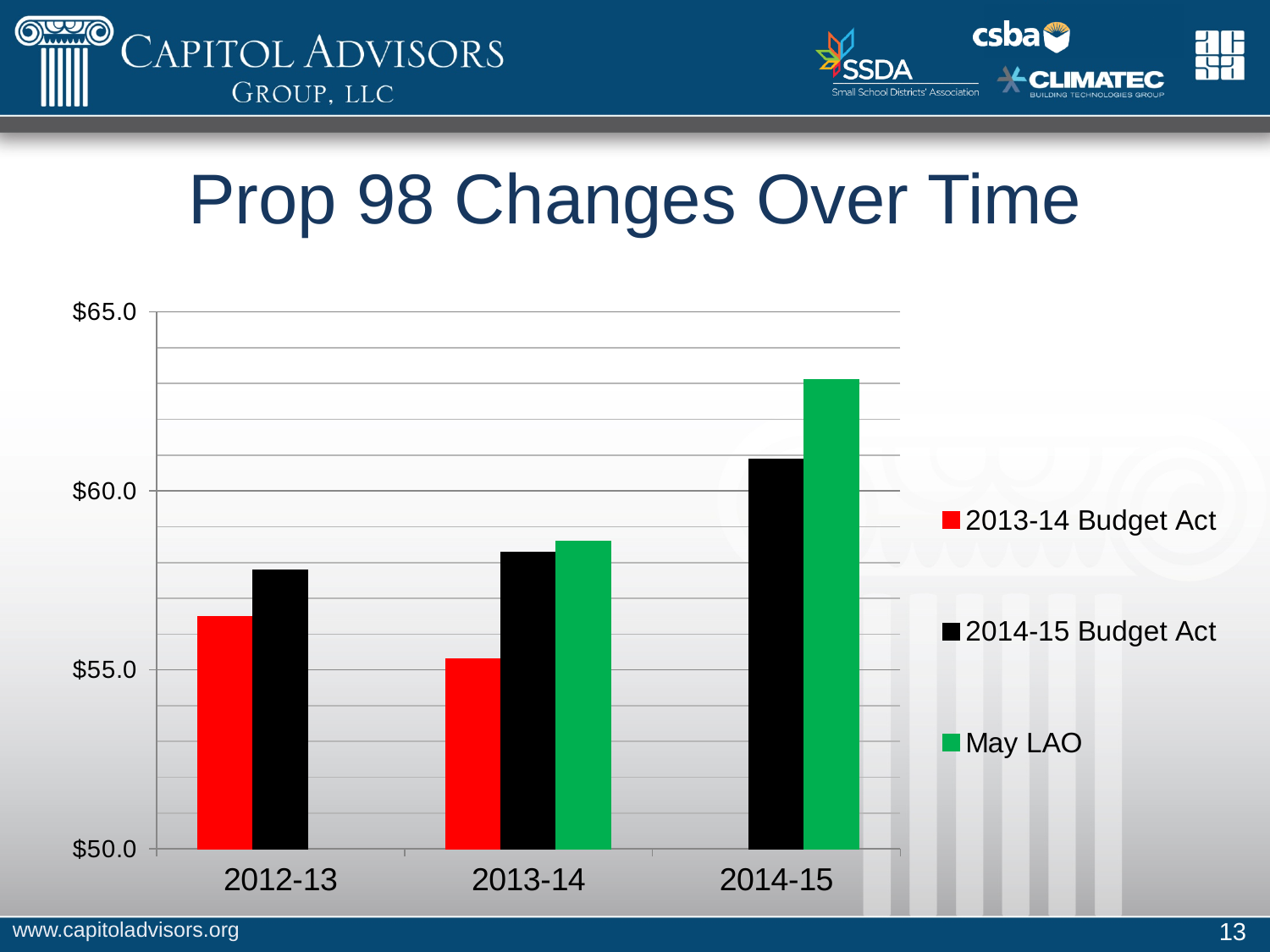
Which bar is the highest in the chart? May LAO for 2014-15 For 2014-15, which is larger: the 2014-15 Budget Act value or the May LAO value? May LAO How many year categories are shown on the x axis? 3 What type of chart is shown on the slide? Bar chart Do the 2014-15 Budget Act values rise or fall from 2012-13 to 2014-15? Rise How many series does the legend list? 3 Is the May LAO value for 2014-15 greater or less than $60.0? greater What is the title of the chart? Prop 98 Changes Over Time Is the 2014-15 Budget Act value for 2012-13 greater or less than $60.0? less Is the 2013-14 Budget Act value for 2012-13 greater or less than $55.0? greater Which bar is the lowest in the chart? 2013-14 Budget Act for 2013-14 For 2012-13, which is larger: the 2013-14 Budget Act value or the 2014-15 Budget Act value? 2014-15 Budget Act